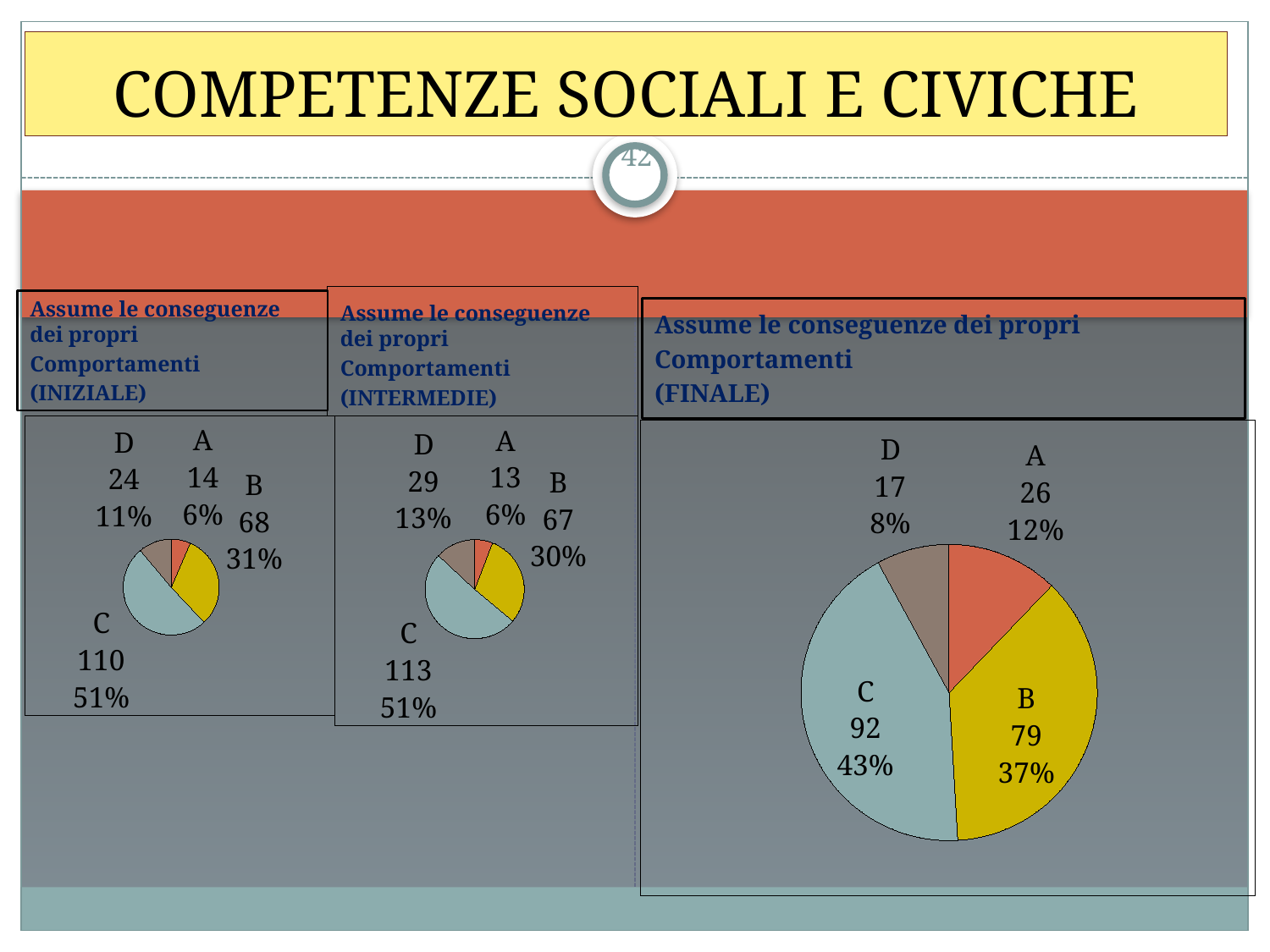
In the FINALE pie chart, what share of the pie does category A represent? 12% In the INIZIALE pie chart, which is larger, the value for D or the value for A? D In the INTERMEDIE pie chart, what is the value for category D? 29 What type of chart is used for the FINALE data? Pie chart In the FINALE pie chart, which category has the largest value? C In the INIZIALE pie chart, what share of the pie does category B represent? 31% How many pie charts are shown on the slide? 3 In the INIZIALE pie chart, what is the value for category C? 110 In the INTERMEDIE pie chart, which category has the smallest value? A How many categories does the INTERMEDIE pie chart show? 4 In the FINALE pie chart, what is the value for category B? 79 In the FINALE pie chart, what is the difference between the values for C and B? 13